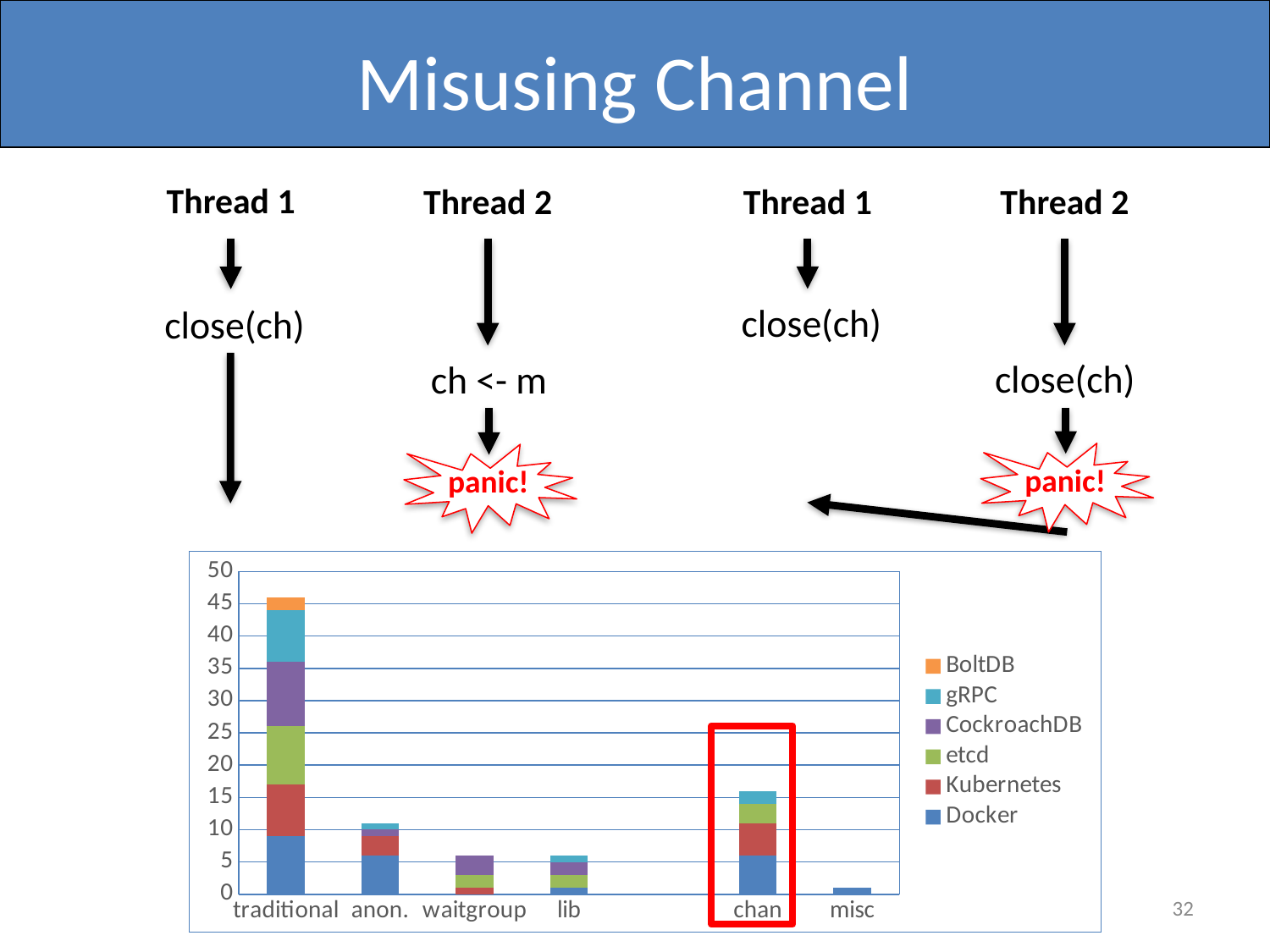
Is the total for chan greater or less than 10? greater Which category has the shortest stacked bar? misc Is the total for waitgroup greater or less than 10? less Is the total for traditional greater or less than 40? greater Which series is listed last (at the bottom) in the legend? Docker Which category's bar is outlined with a red box? chan What kind of chart is shown on the slide? bar chart How many series does the chart's legend list? 6 Which has the larger total, chan or waitgroup? chan Which category has the tallest stacked bar? traditional How many categories are shown on the x axis of the chart? 6